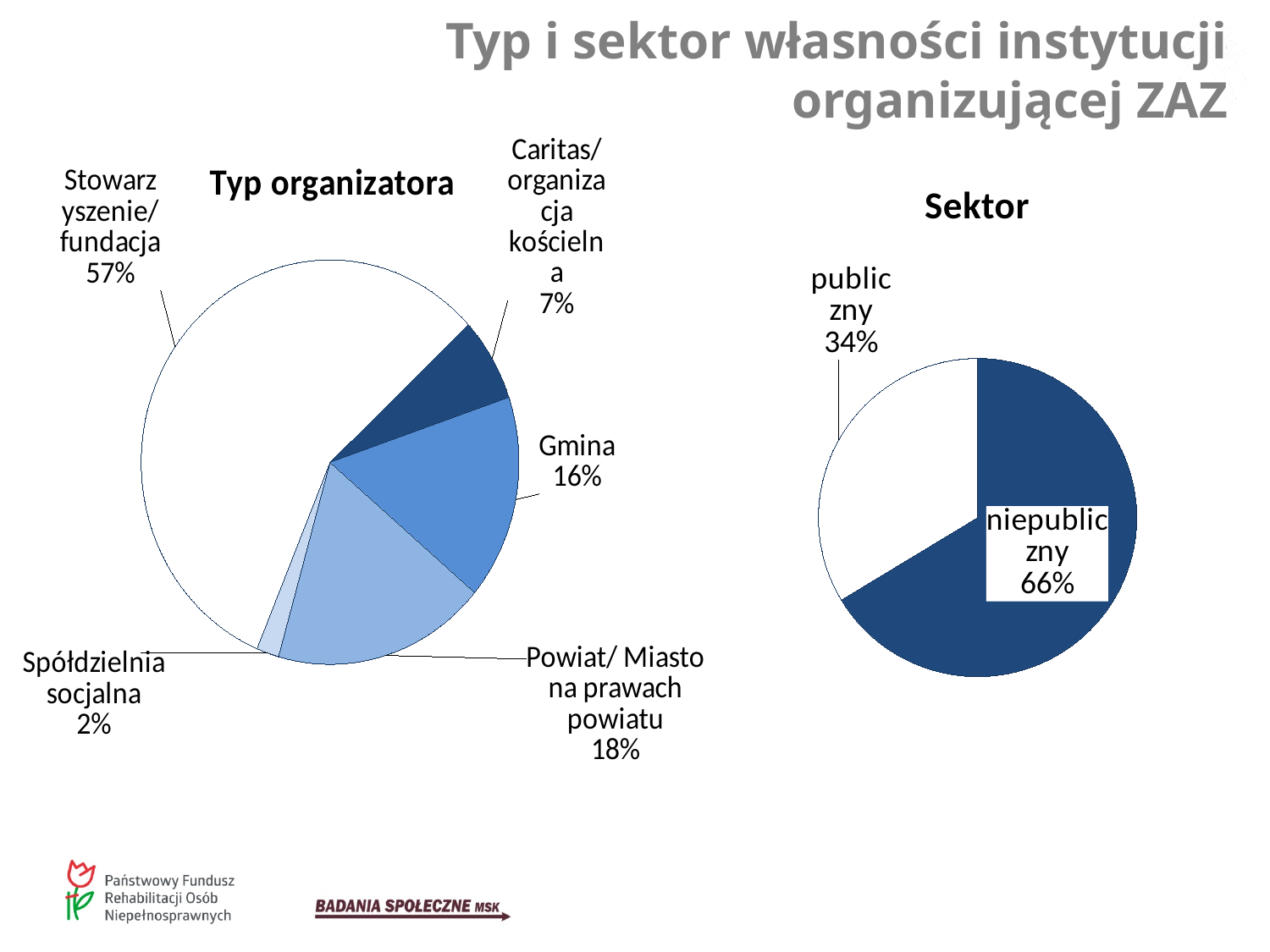
In the 'Typ organizatora' chart, how many categories are shown? 5 In the 'Sektor' chart, what share does publiczny have? 34% In the 'Typ organizatora' chart, what share does Gmina have? 16% In the 'Typ organizatora' chart, which is larger: Caritas/organizacja kościelna or Gmina? Gmina In the 'Typ organizatora' chart, what share does Powiat/ Miasto na prawach powiatu have? 18% In the 'Typ organizatora' chart, which category has the smallest share? Spółdzielnia socjalna In the 'Typ organizatora' chart, what share does Stowarzyszenie/fundacja have? 57% In the 'Sektor' chart, what is the difference between niepubliczny and publiczny? 32% In the 'Typ organizatora' chart, which category has the largest share? Stowarzyszenie/fundacja In the 'Sektor' chart, what share does niepubliczny have? 66% What type of chart is the 'Sektor' chart? Pie chart In the 'Typ organizatora' chart, what is the difference between the shares of Powiat/ Miasto na prawach powiatu and Gmina? 2%